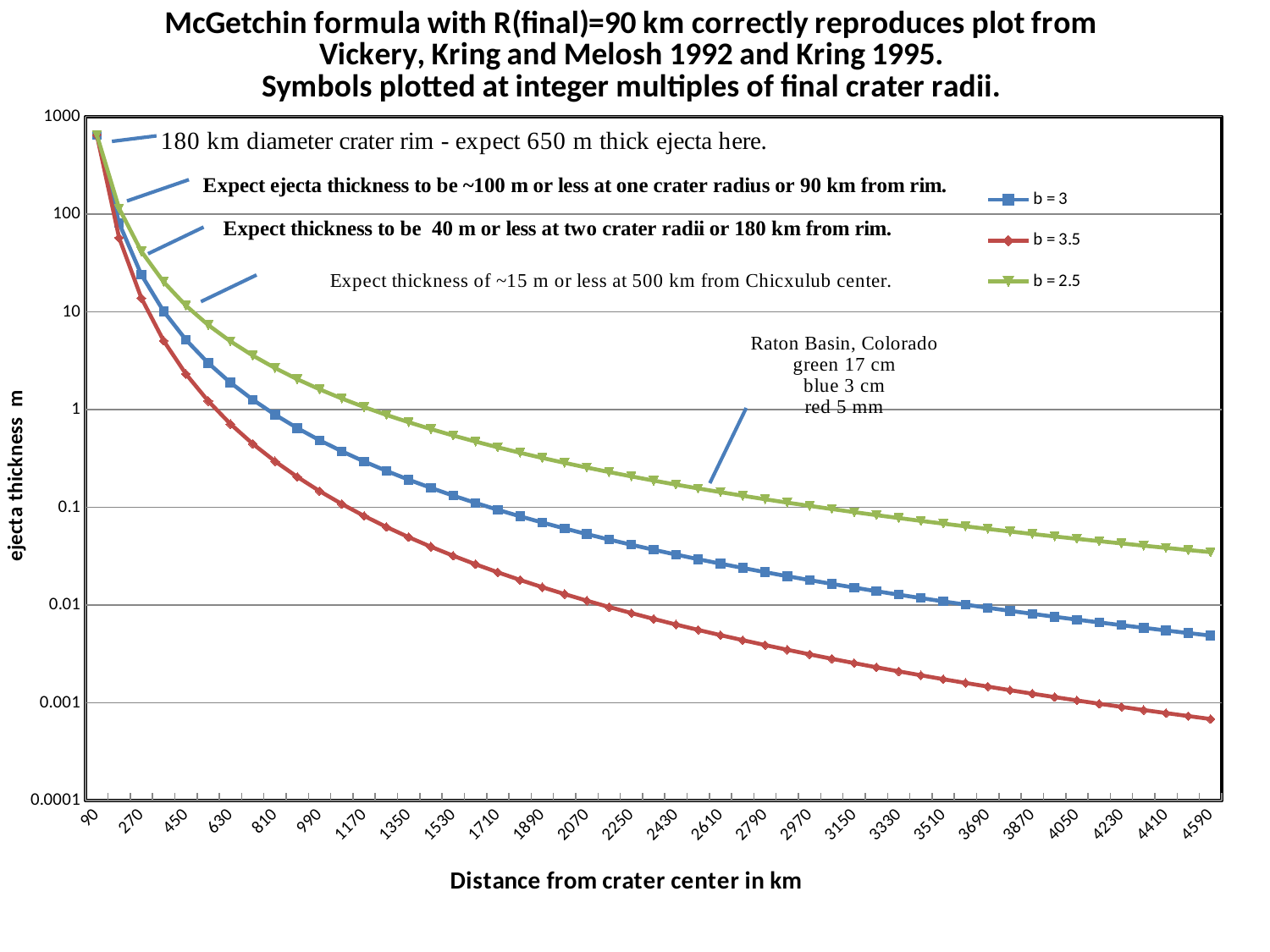
At 2610 km, which series has the larger ejecta thickness, b = 2.5 or b = 3.5? b = 2.5 Is the value for b = 3.5 at 2610 km greater or less than 0.01? less Is the value for b = 2.5 at 4590 km greater or less than 0.1? less What kind of chart is shown on the slide? line chart Is the value for b = 2.5 at 2610 km greater or less than 0.1? greater Which series has the highest ejecta thickness at 4590 km from the crater center? b = 2.5 Do the ejecta thickness values rise or fall as distance from the crater center increases? fall Which series has the lowest ejecta thickness at 4590 km from the crater center? b = 3.5 How many series does the legend list? 3 What is the title of the x axis? Distance from crater center in km